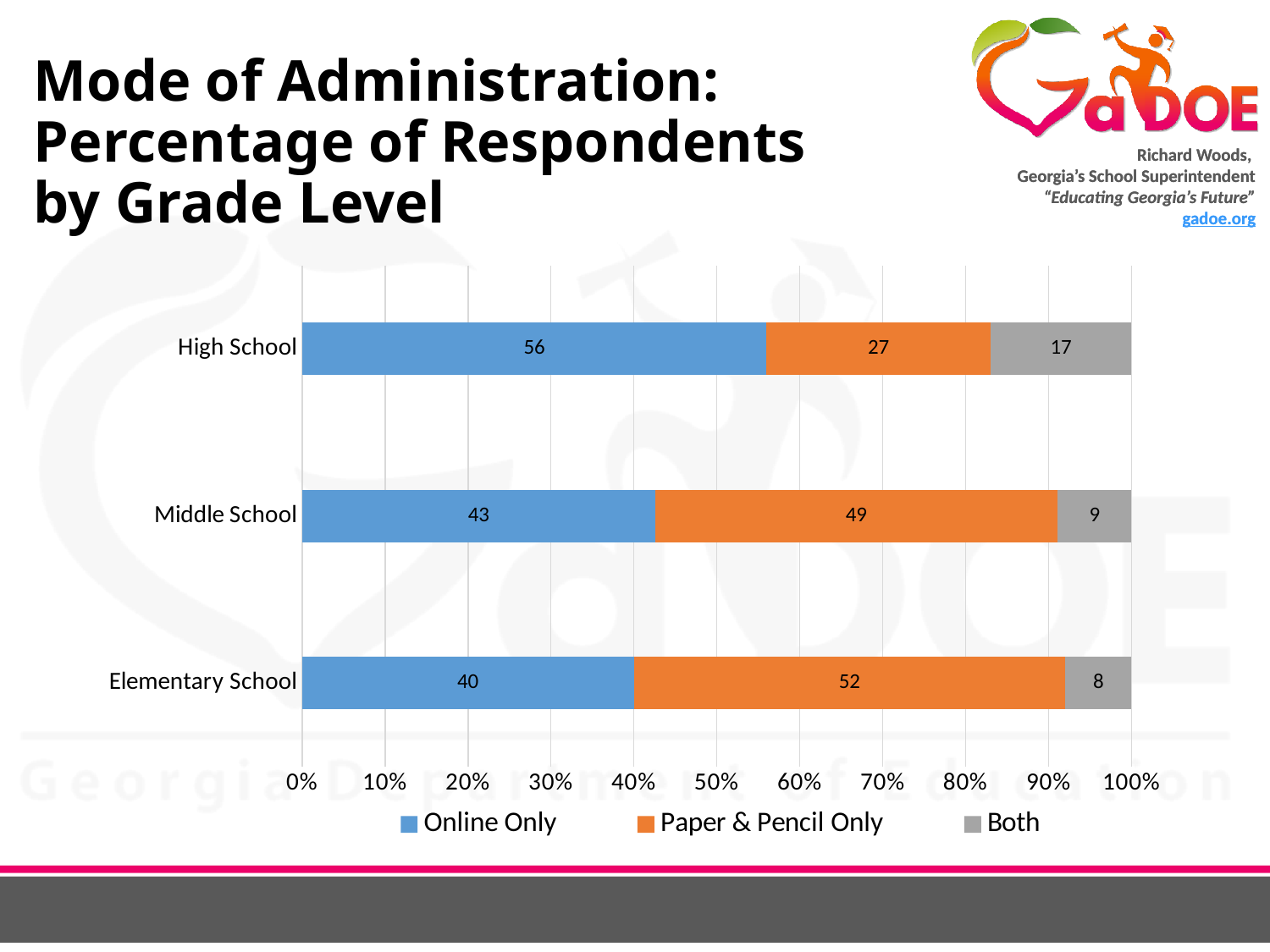
How many series does the legend list? 3 What kind of chart is shown on the slide? Stacked bar chart Which grade level has the lowest Paper & Pencil Only value? High School Which colour represents the Both series in the legend? Grey What is the difference between the Paper & Pencil Only values for Elementary School and High School? 25 Which is larger for Middle School: Online Only or Paper & Pencil Only? Paper & Pencil Only What is the Paper & Pencil Only value for Middle School? 49 Which grade level has the highest Online Only value? High School What is the Online Only value for High School? 56 What is the Both value for Elementary School? 8 How many grade levels are shown on the chart? 3 What is the total of the stacked bar for High School? 100